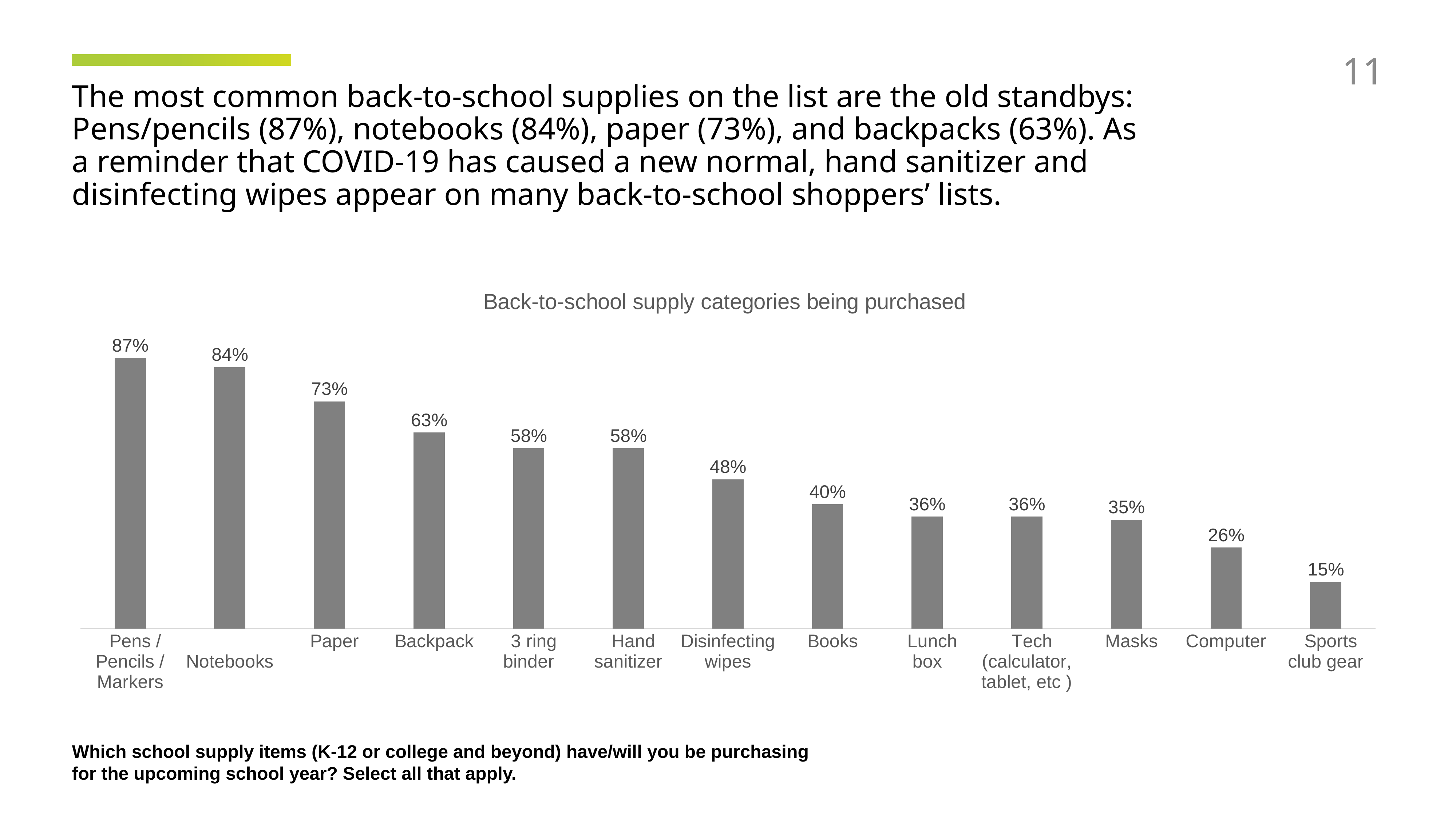
Do the values rise or fall from left to right across the categories? Fall What is the value shown for Disinfecting wipes? 48% What percentage is shown for Computer? 26% Which is larger, the value for Backpack or the value for 3 ring binder? Backpack Which category has the lowest value? Sports club gear What is the difference between the values for Notebooks and Paper? 11% What kind of chart is shown on the slide? Bar chart What percentage of respondents are purchasing Hand sanitizer? 58% What is the difference between the values for Books and Masks? 5% How many categories are shown in the chart? 13 What is the title of the chart? Back-to-school supply categories being purchased Which category has the highest value? Pens / Pencils / Markers